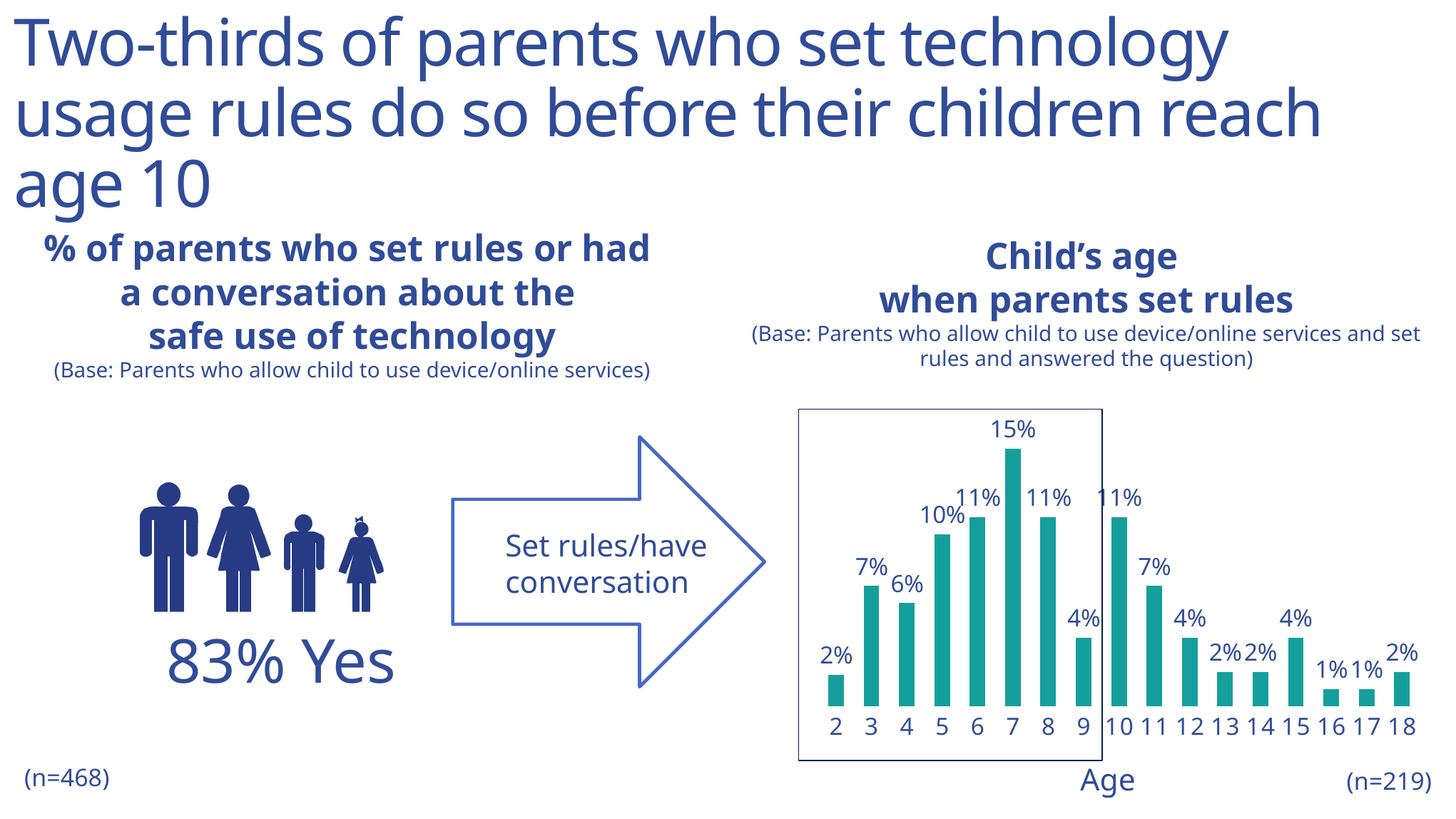
What type of chart is used to show the child's age when parents set rules? bar chart What is the x-axis label of the chart of child's age when parents set rules? Age In the chart of child's age when parents set rules, do the values rise or fall from age 7 to age 9? fall In the chart of child's age when parents set rules, what percentage of parents set rules when the child was age 7? 15% How many ages are shown on the x axis of the chart of child's age when parents set rules? 17 In the chart of child's age when parents set rules, what is the value for age 18? 2% In the chart of child's age when parents set rules, which is larger, the value for age 9 or the value for age 10? age 10 In the chart of child's age when parents set rules, what is the difference between the values for age 7 and age 8? 4% In the chart of child's age when parents set rules, what is the difference between the values for age 3 and age 4? 1% In the chart of child's age when parents set rules, what is the value for age 12? 4% In the chart of child's age when parents set rules, what is the value for age 5? 10% In the chart of child's age when parents set rules, which age has the highest percentage? 7